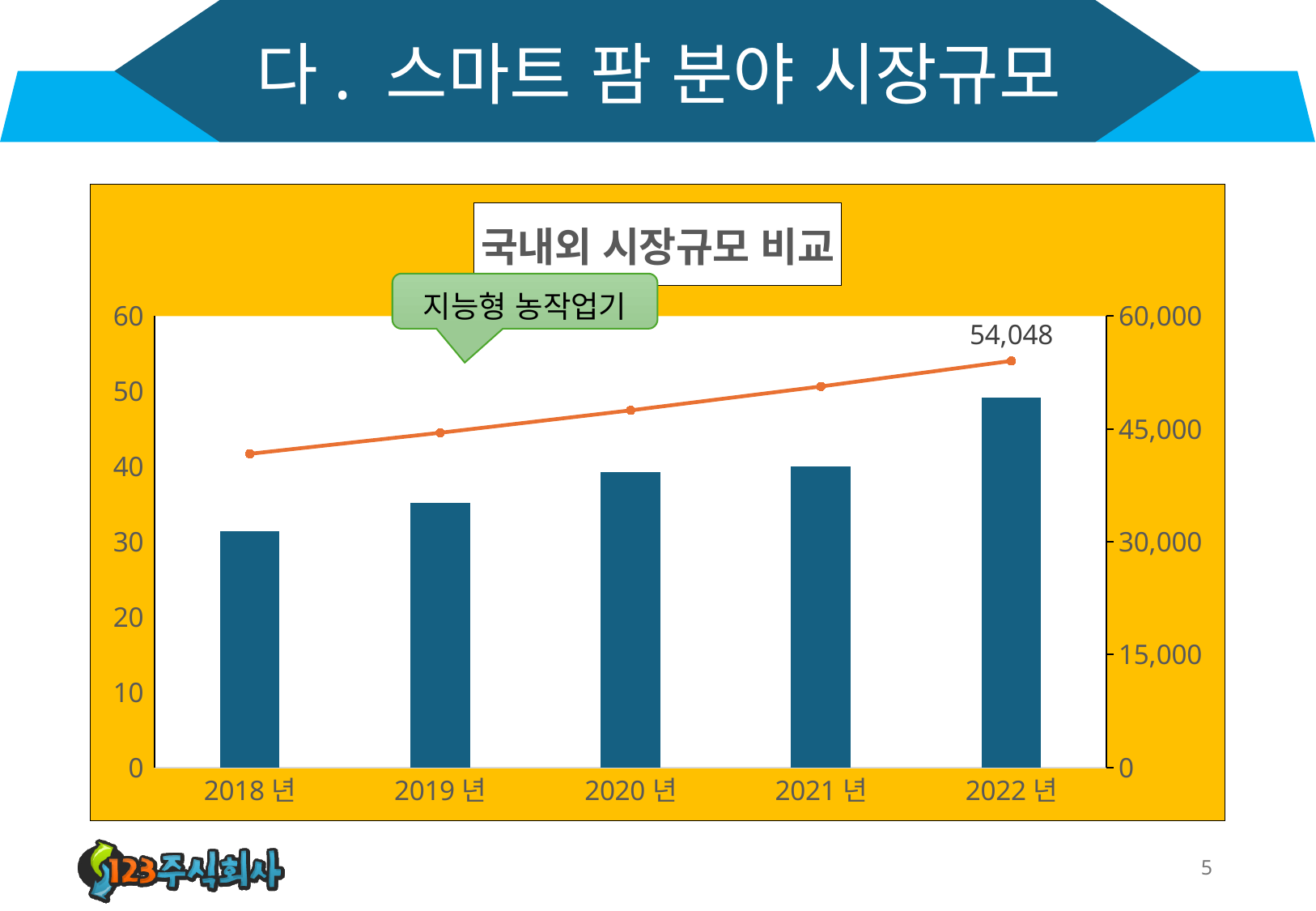
What is the title of the chart? 국내외 시장규모 비교 Which bar is taller, 2018 년 or 2022 년? 2022 년 Which year has the tallest bar? 2022 년 How many years are shown on the x axis? 5 Do the bar values rise or fall from 2018 년 to 2022 년? rise Is the bar value for 2019 년 greater or less than 40 on the left axis? less Which year has the shortest bar? 2018 년 Is the line value for 2018 년 greater or less than 45,000 on the right axis? less Is the bar value for 2022 년 greater or less than 40 on the left axis? greater What is the value of the data label shown on the line for 2022 년? 54,048 What kind of chart is this? Combined bar and line chart